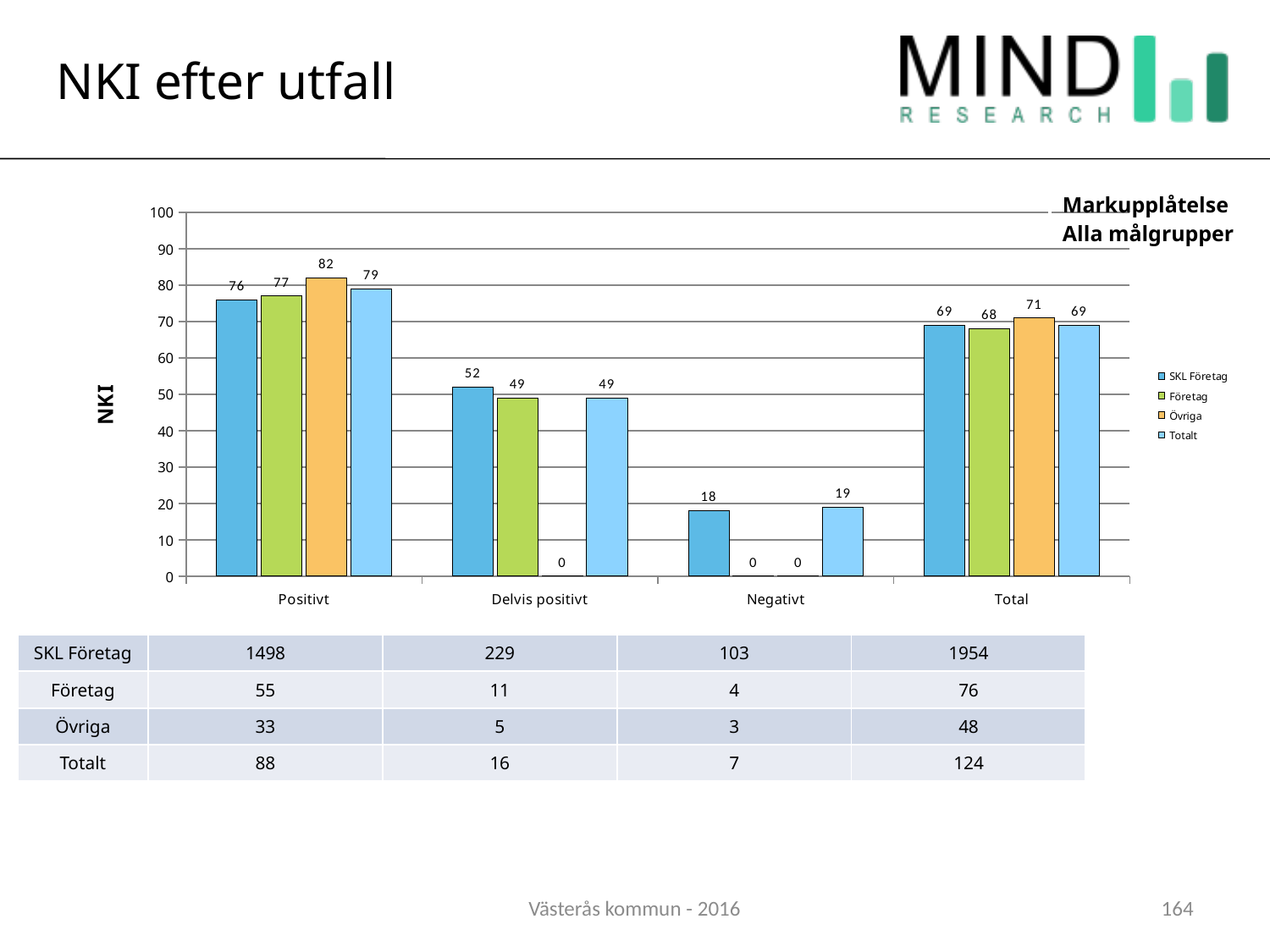
How many series does the chart legend list? 4 Which is larger: the SKL Företag value for Delvis positivt or the Totalt value for Delvis positivt? SKL Företag Which category has the lowest NKI value for SKL Företag? Negativt How many categories are shown on the x axis of the chart? 4 Which series has the highest NKI value in the Positivt category? Övriga What is the NKI value for Totalt in the Negativt category? 19 What is the NKI value for SKL Företag in the Delvis positivt category? 52 What is the NKI value for Övriga in the Positivt category? 82 What is the NKI value for Företag in the Total category? 68 What kind of chart is shown on the slide? Bar chart What is the difference between the Övriga and SKL Företag values in the Positivt category? 6 What is the label on the vertical axis of the chart? NKI